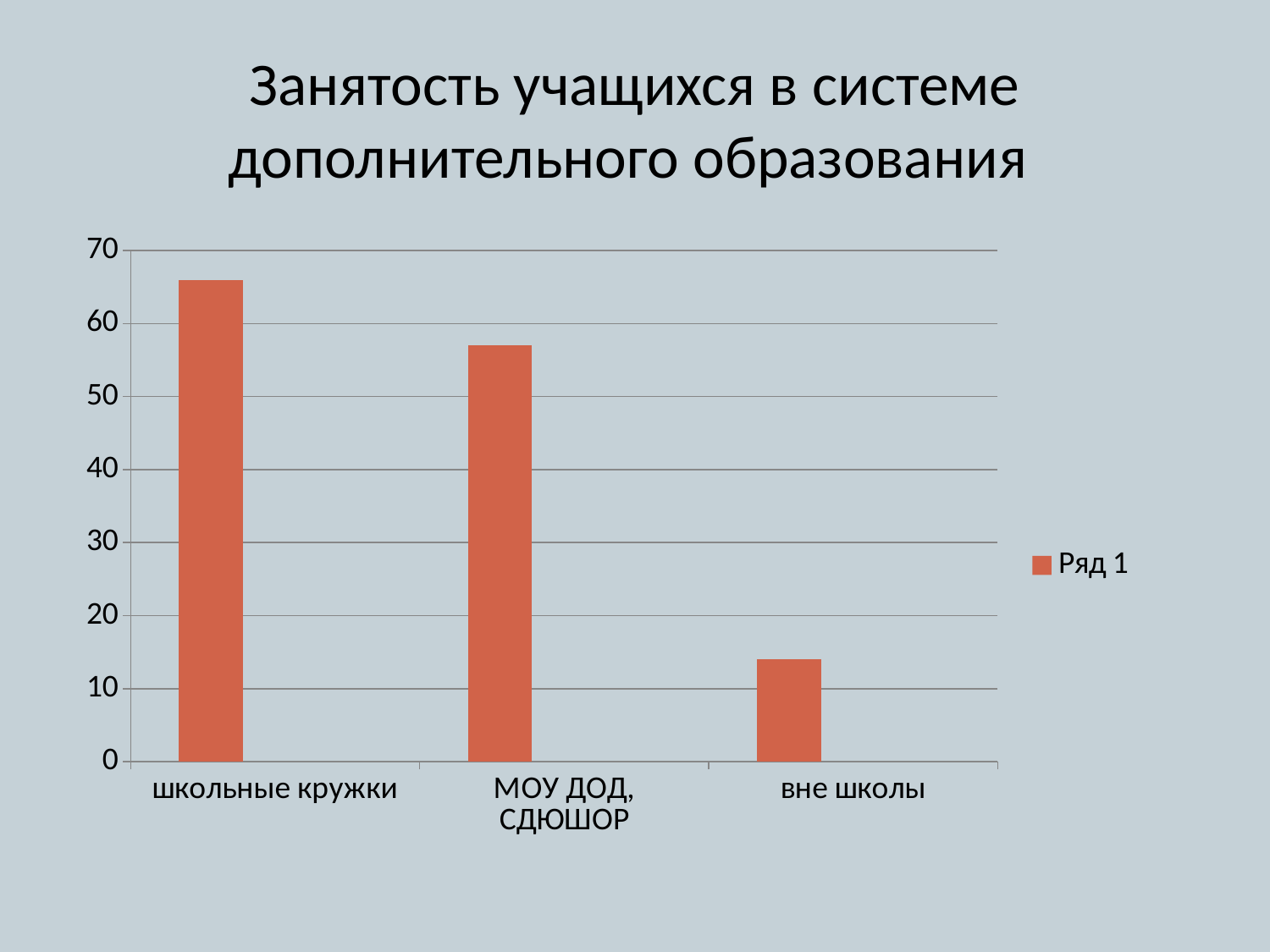
How many categories are shown on the x axis? 3 Which is larger, the value for школьные кружки or the value for МОУ ДОД, СДЮШОР? школьные кружки Is the value for МОУ ДОД, СДЮШОР greater or less than 50? greater Is the value for школьные кружки greater or less than 60? greater How many series does the legend list? 1 Which category has the highest value? школьные кружки Do the values rise or fall from left to right along the x axis? fall What is the title of the chart? Занятость учащихся в системе дополнительного образования Is the value for вне школы greater or less than 20? less Which category has the lowest value? вне школы What kind of chart is shown on the slide? bar chart What is the name of the series in the legend? Ряд 1